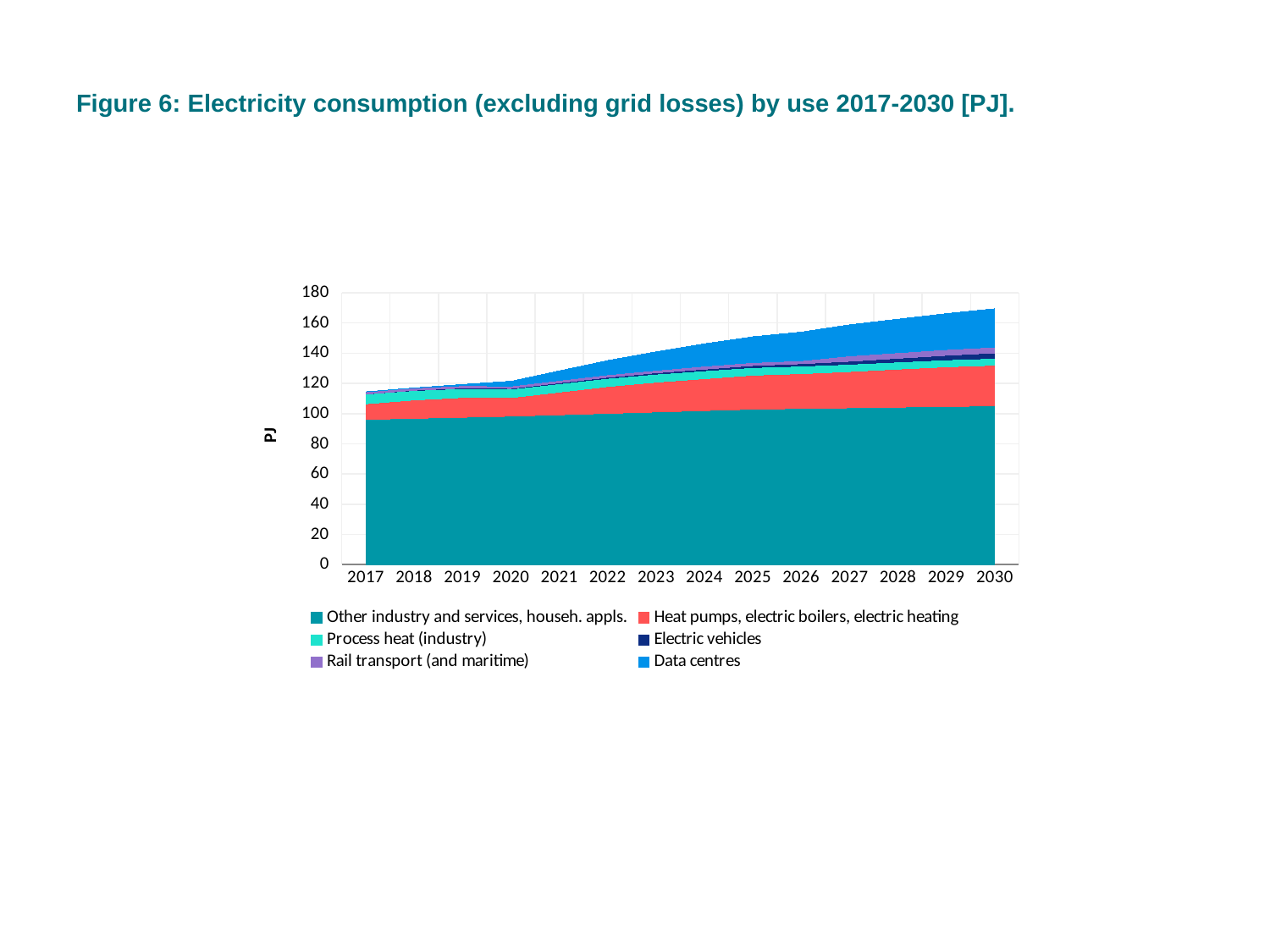
Is the total electricity consumption in 2017 greater or less than 120 PJ? less Which is larger in 2030: the consumption of 'Data centres' or of 'Electric vehicles'? Data centres What kind of chart is shown on the slide? Stacked area chart How many years are shown along the x axis? 14 Is the value for 'Other industry and services, househ. appls.' in 2017 greater or less than 100 PJ? less Does total electricity consumption rise or fall from 2017 to 2030? Rises Is the total electricity consumption in 2030 greater or less than 160 PJ? greater What is the title of the chart? Figure 6: Electricity consumption (excluding grid losses) by use 2017-2030 [PJ]. What unit is shown on the y axis label? PJ Which series accounts for the largest share of electricity consumption in 2030? Other industry and services, househ. appls. How many series does the legend list? 6